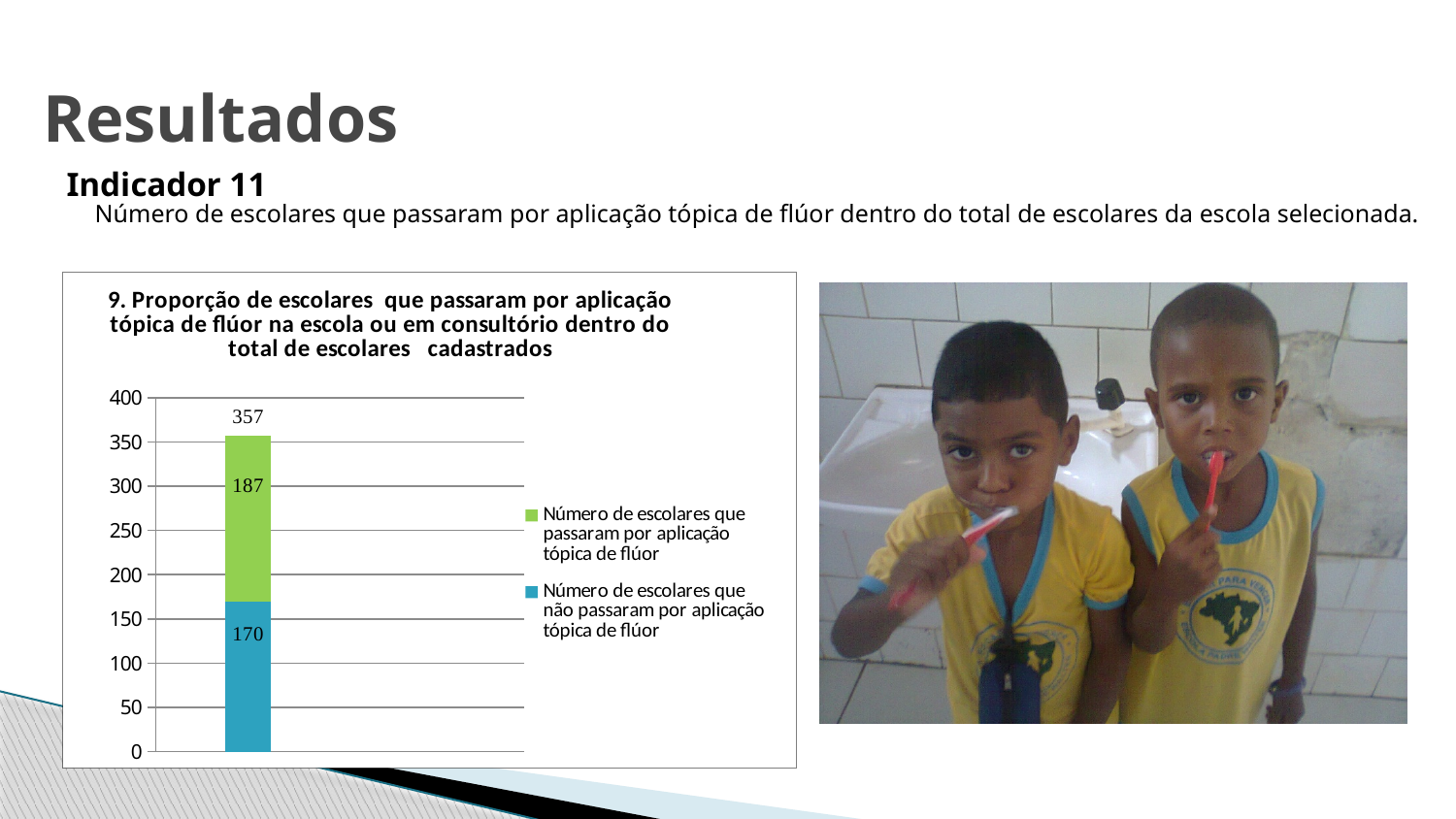
What is the total of the stacked bar? 357 What is the maximum value shown on the chart's vertical axis? 400 How many series does the chart legend list? 2 What is the value for 'Número de escolares que passaram por aplicação tópica de flúor'? 187 Which is larger: the number of students who received topical fluoride application or the number who did not? Número de escolares que passaram por aplicação tópica de flúor What type of chart is shown on the slide? bar chart Is the total of the stacked bar greater or less than 350? greater How many bars are plotted in the chart? 1 Which colour represents 'Número de escolares que passaram por aplicação tópica de flúor' in the chart? green What is the value for 'Número de escolares que não passaram por aplicação tópica de flúor'? 170 What is the difference between the number of students who received topical fluoride application and those who did not? 17